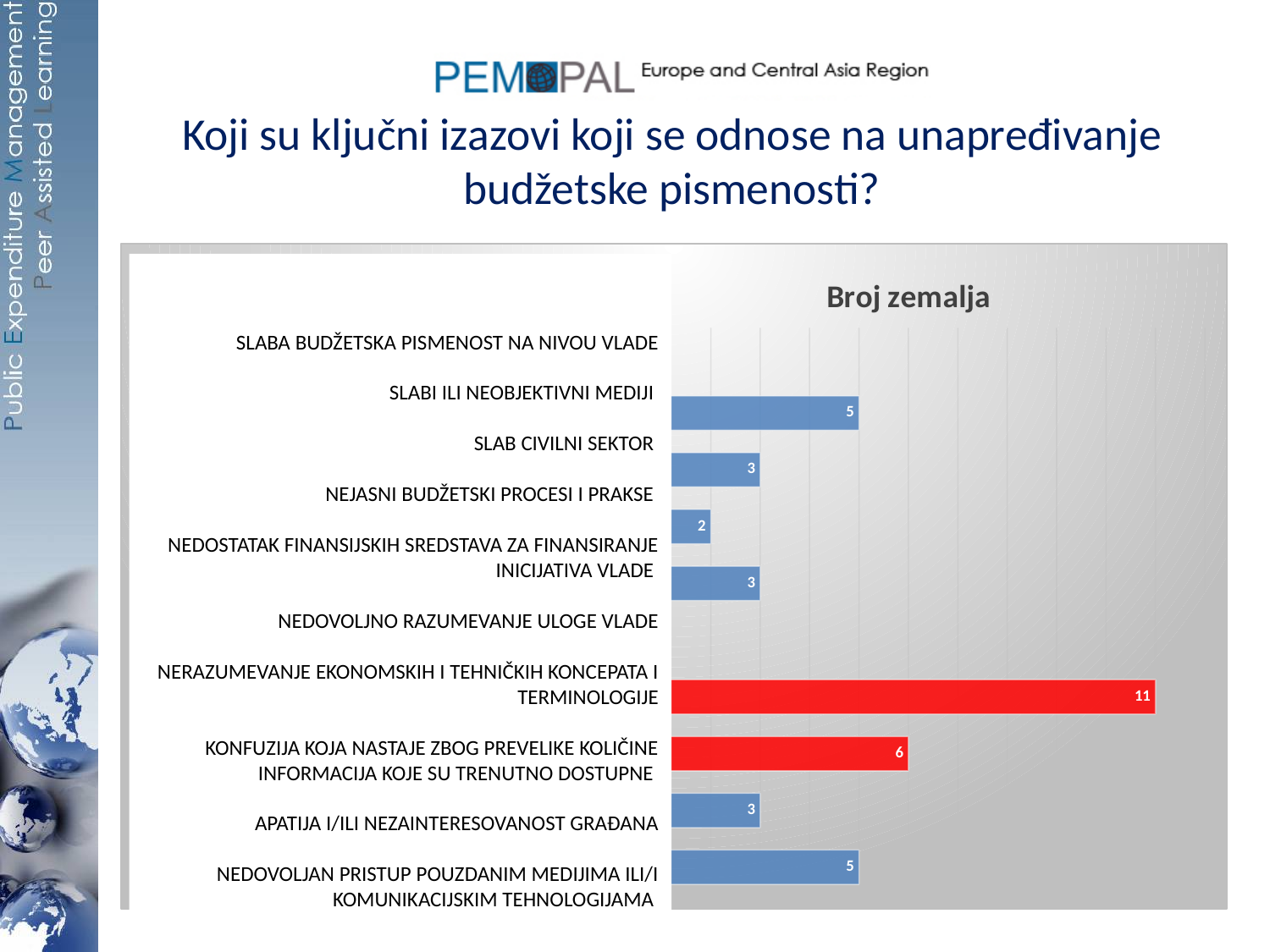
What colour is the bar with the highest value? red What is the value for NEDOVOLJAN PRISTUP POUZDANIM MEDIJIMA ILI/I KOMUNIKACIJSKIM TEHNOLOGIJAMA? 5 How many bars with data labels are plotted in the chart? 8 What is the difference between the value for NERAZUMEVANJE EKONOMSKIH I TEHNIČKIH KONCEPATA I TERMINOLOGIJE and the value for KONFUZIJA KOJA NASTAJE ZBOG PREVELIKE KOLIČINE INFORMACIJA KOJE SU TRENUTNO DOSTUPNE? 5 What is the value for NERAZUMEVANJE EKONOMSKIH I TEHNIČKIH KONCEPATA I TERMINOLOGIJE? 11 Which category has the highest value in the chart? NERAZUMEVANJE EKONOMSKIH I TEHNIČKIH KONCEPATA I TERMINOLOGIJE What is the value for SLABI ILI NEOBJEKTIVNI MEDIJI? 5 What kind of chart is shown on the slide? bar chart What is the value for APATIJA I/ILI NEZAINTERESOVANOST GRAĐANA? 3 What is the value for KONFUZIJA KOJA NASTAJE ZBOG PREVELIKE KOLIČINE INFORMACIJA KOJE SU TRENUTNO DOSTUPNE? 6 Which is larger: the value for KONFUZIJA KOJA NASTAJE ZBOG PREVELIKE KOLIČINE INFORMACIJA KOJE SU TRENUTNO DOSTUPNE or the value for APATIJA I/ILI NEZAINTERESOVANOST GRAĐANA? KONFUZIJA KOJA NASTAJE ZBOG PREVELIKE KOLIČINE INFORMACIJA KOJE SU TRENUTNO DOSTUPNE What is the title of the chart? Broj zemalja